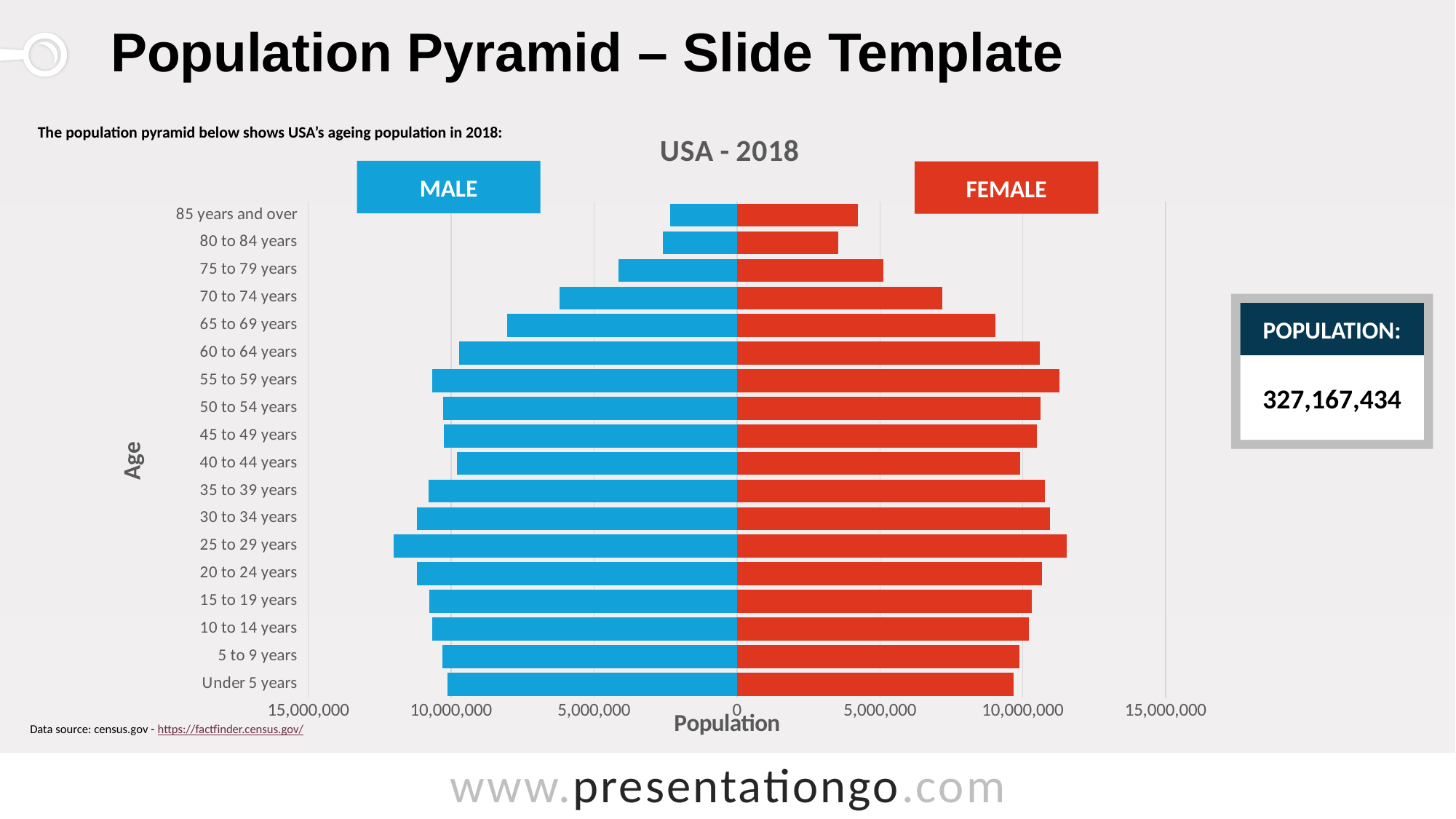
Is the female population for 85 years and over greater or less than 5,000,000? less Which colour represents the female series? Red What is the title of the chart? USA - 2018 Is the male population for 70 to 74 years greater or less than 10,000,000? less How many series does the chart show? 2 Is the male population for 25 to 29 years greater or less than 10,000,000? greater Which age group has the largest male population? 25 to 29 years What kind of chart is shown on the slide? Bar chart How many age groups are plotted on the chart? 18 Which age group has the smallest female population? 80 to 84 years For the 85 years and over group, which is larger, the male or the female population? Female